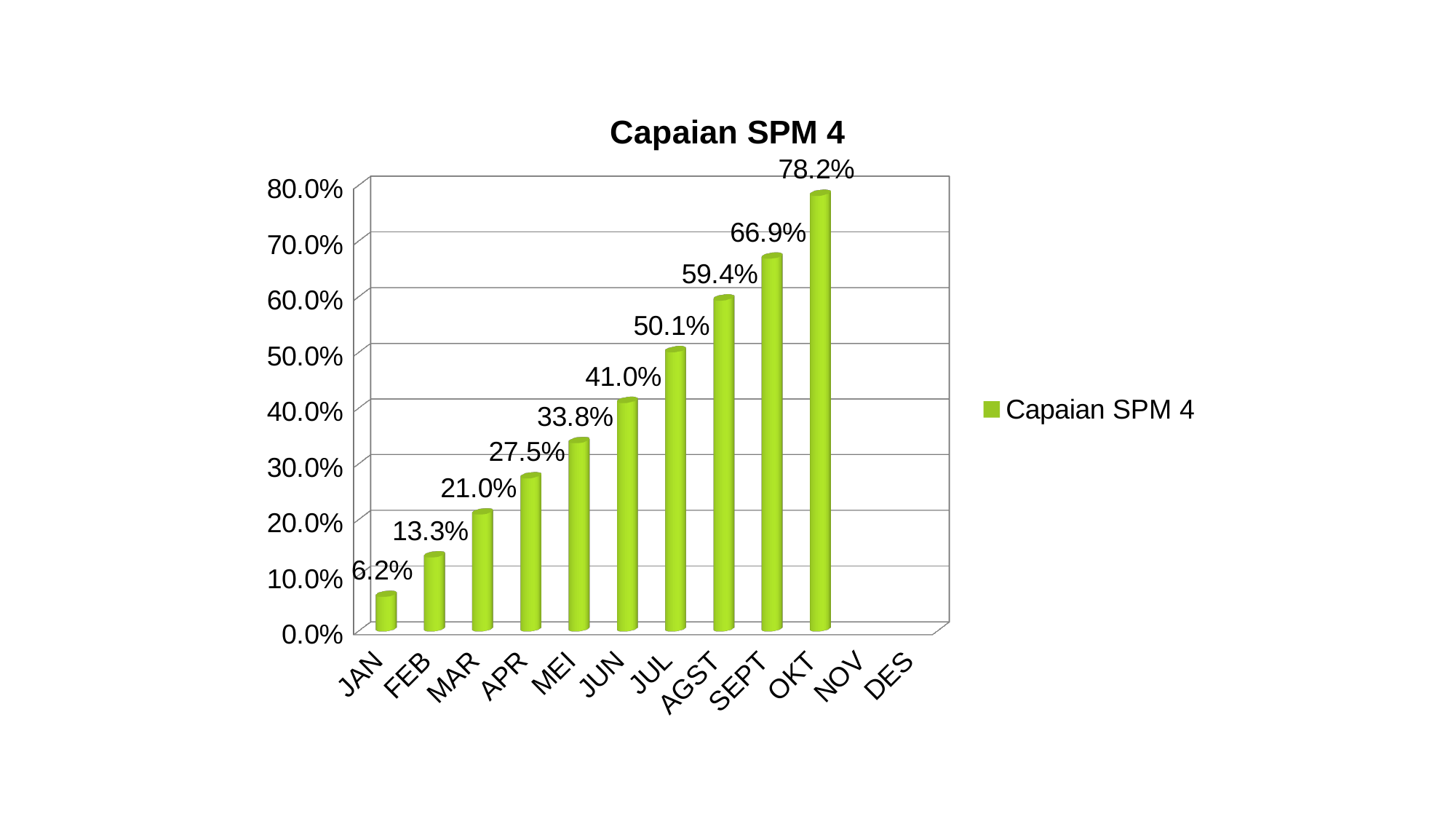
Which month has the highest value? OKT What kind of chart is shown? bar chart What is the value for JUL? 50.1% Which is larger, the value for APR or the value for MEI? MEI Is the value for AGST greater or less than 50.0%? greater What is the value for MAR? 21.0% What is the value for SEPT? 66.9% Do the values rise or fall from JAN to OKT? rise Which month with a plotted bar has the lowest value? JAN How many series does the legend list? 1 How many months have a plotted bar? 10 What is the difference between the values for OKT and SEPT? 11.3%